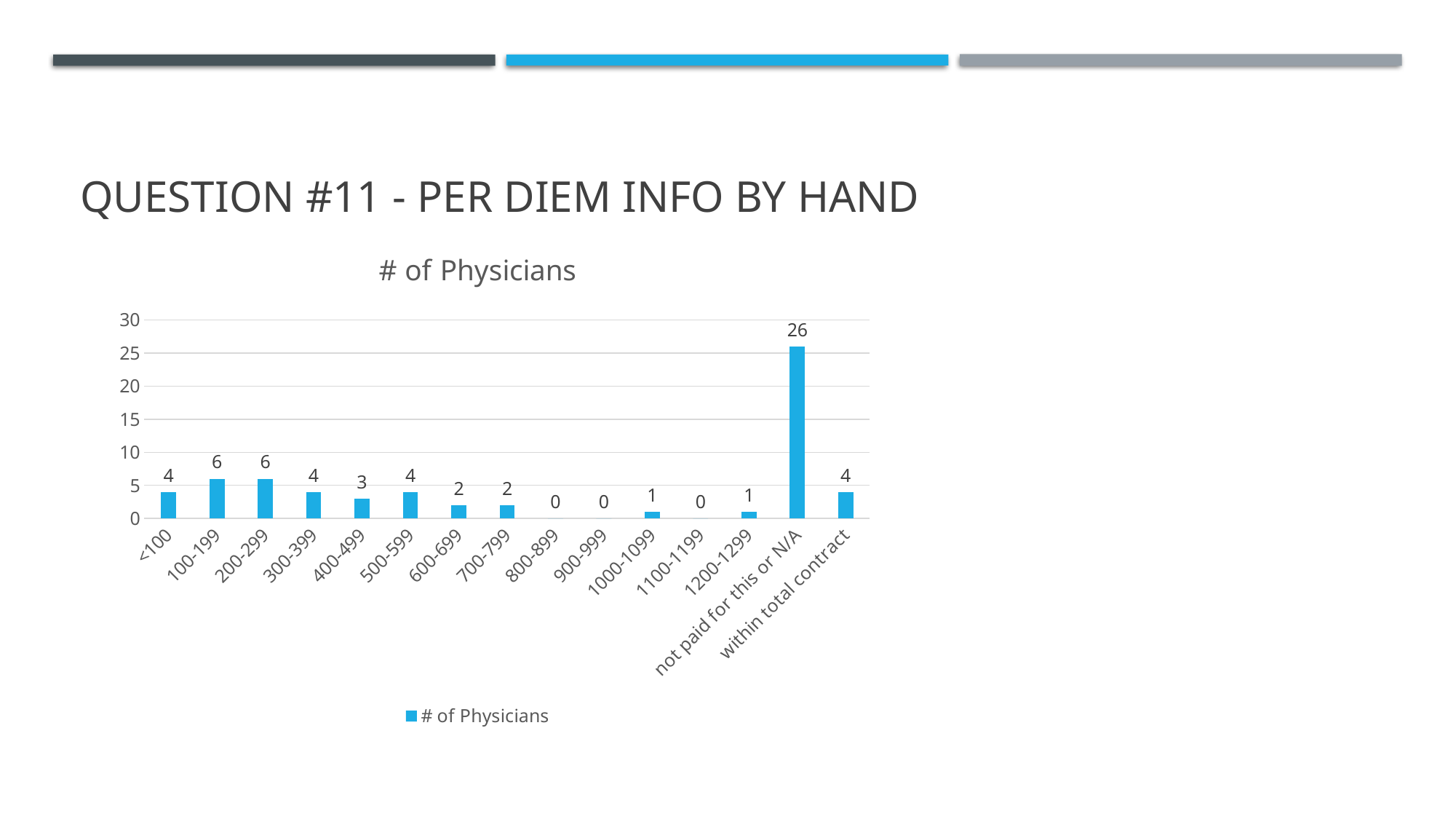
What kind of chart is shown on the slide? bar chart How many physicians are in the 400-499 category? 3 What is the value for the 'within total contract' category? 4 What is the difference between the values for 200-299 and 600-699? 4 Which is larger, the value for <100 or the value for 700-799? <100 How many categories are shown on the x axis? 15 What is the value for the 'not paid for this or N/A' category? 26 Which category has the highest value? not paid for this or N/A Is the value for 'not paid for this or N/A' greater or less than 25? greater How many series does the legend list? 1 What is the difference between the values for 'not paid for this or N/A' and 100-199? 20 What is the title of the chart? # of Physicians